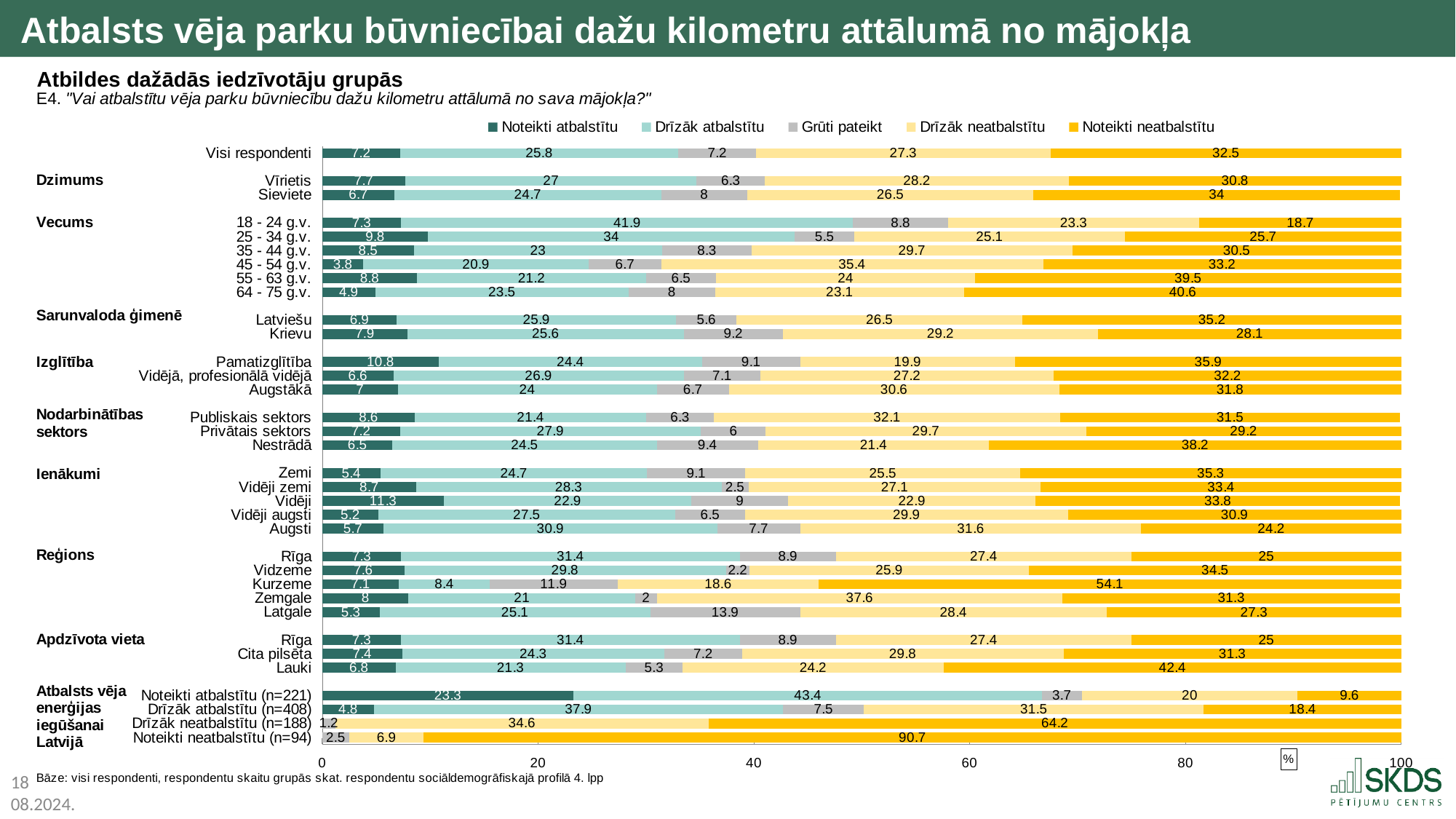
What kind of chart is shown on the slide? Stacked bar chart What is the value of "Noteikti neatbalstītu" for "Kurzeme"? 54.1 What is the value of "Noteikti neatbalstītu" for "Visi respondenti"? 32.5 What is the value of "Noteikti atbalstītu" for "Noteikti atbalstītu (n=221)"? 23.3 What is the value of "Drīzāk atbalstītu" for "18 - 24 g.v."? 41.9 What is the value of "Noteikti neatbalstītu" for "Noteikti neatbalstītu (n=94)"? 90.7 Among the "Reģions" groups, which has the highest value for "Noteikti neatbalstītu"? Kurzeme How many series does the legend list? 5 Among the "Vecums" groups, which has the lowest value for "Noteikti atbalstītu"? 45 - 54 g.v. How many categories are listed under "Reģions"? 5 What is the difference between the "Noteikti neatbalstītu" values for "Sieviete" and "Vīrietis"? 3.2 Which has a larger "Noteikti neatbalstītu" value, "Latviešu" or "Krievu"? Latviešu